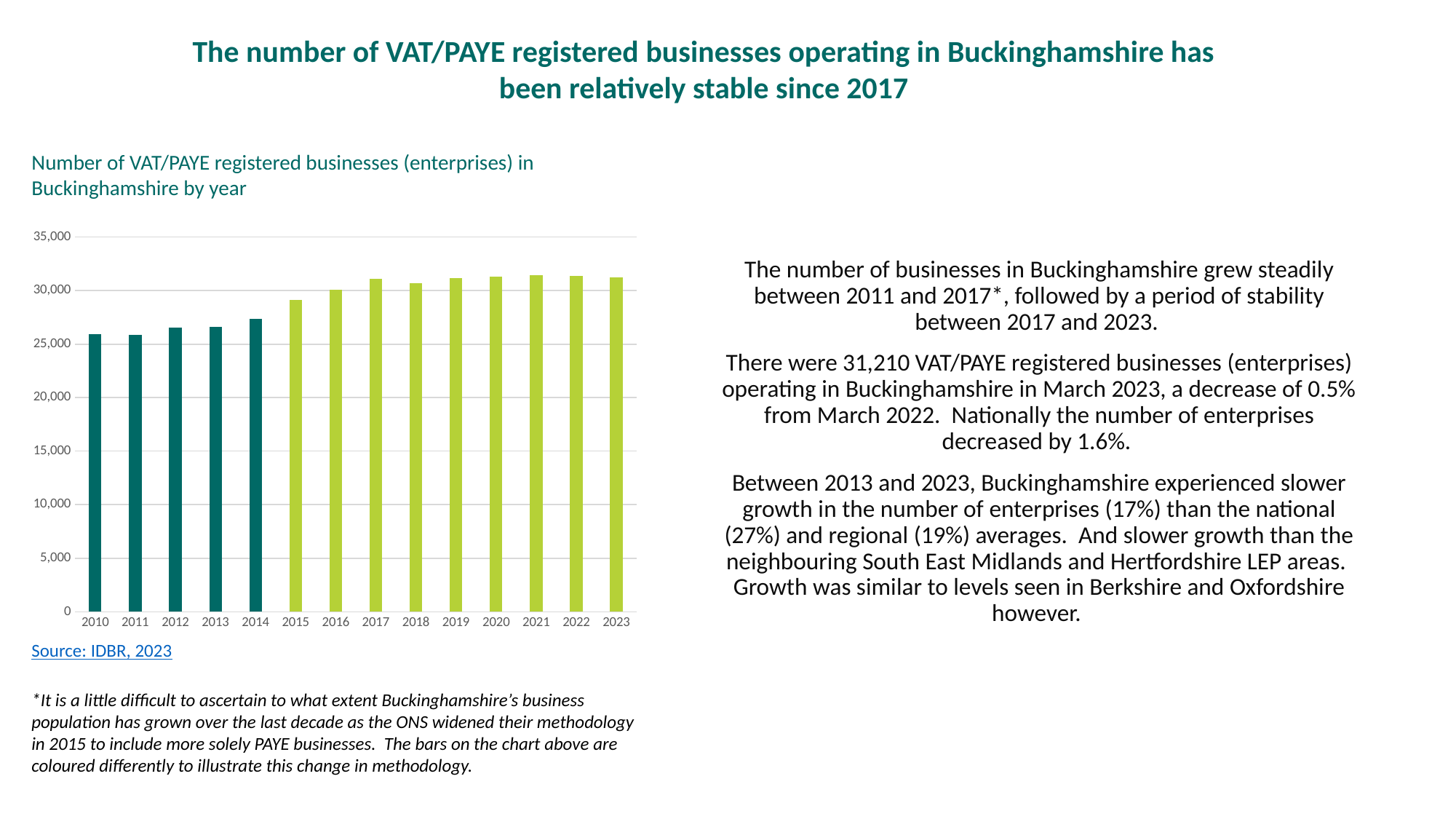
Do the values generally rise or fall between 2011 and 2017? rise From which year onwards are the bars coloured light green instead of dark teal? 2015 Is the value for 2017 greater or less than 30,000? greater Is the value for 2010 greater or less than 30,000? less What is the title of the chart? Number of VAT/PAYE registered businesses (enterprises) in Buckinghamshire by year Which year has the larger value, 2014 or 2015? 2015 How many years are plotted on the chart? 14 What kind of chart is shown on the slide? Bar chart Is the value for 2015 greater or less than 30,000? less Which year has the larger value, 2010 or 2023? 2023